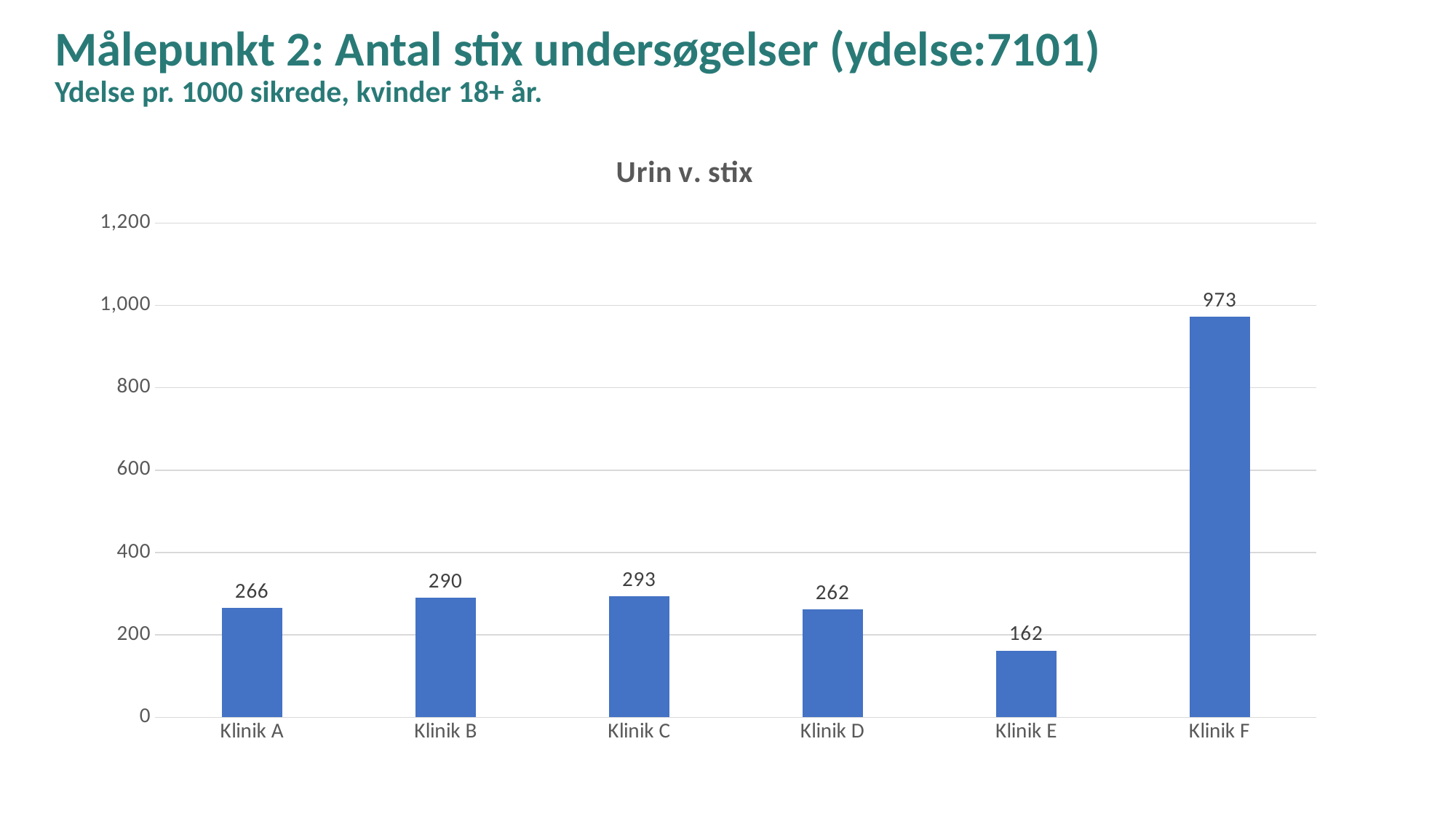
Which clinic has the highest value? Klinik F How many clinics are shown on the chart? 6 What is the value for Klinik F? 973 Is the value for Klinik F greater or less than 800? greater What is the title of the chart? Urin v. stix What is the value for Klinik A? 266 Which is larger, the value for Klinik A or the value for Klinik E? Klinik A What kind of chart is shown on the slide? bar chart Which clinic has the lowest value? Klinik E What is the difference between the values for Klinik B and Klinik D? 28 What is the difference between the values for Klinik F and Klinik C? 680 What is the value for Klinik E? 162